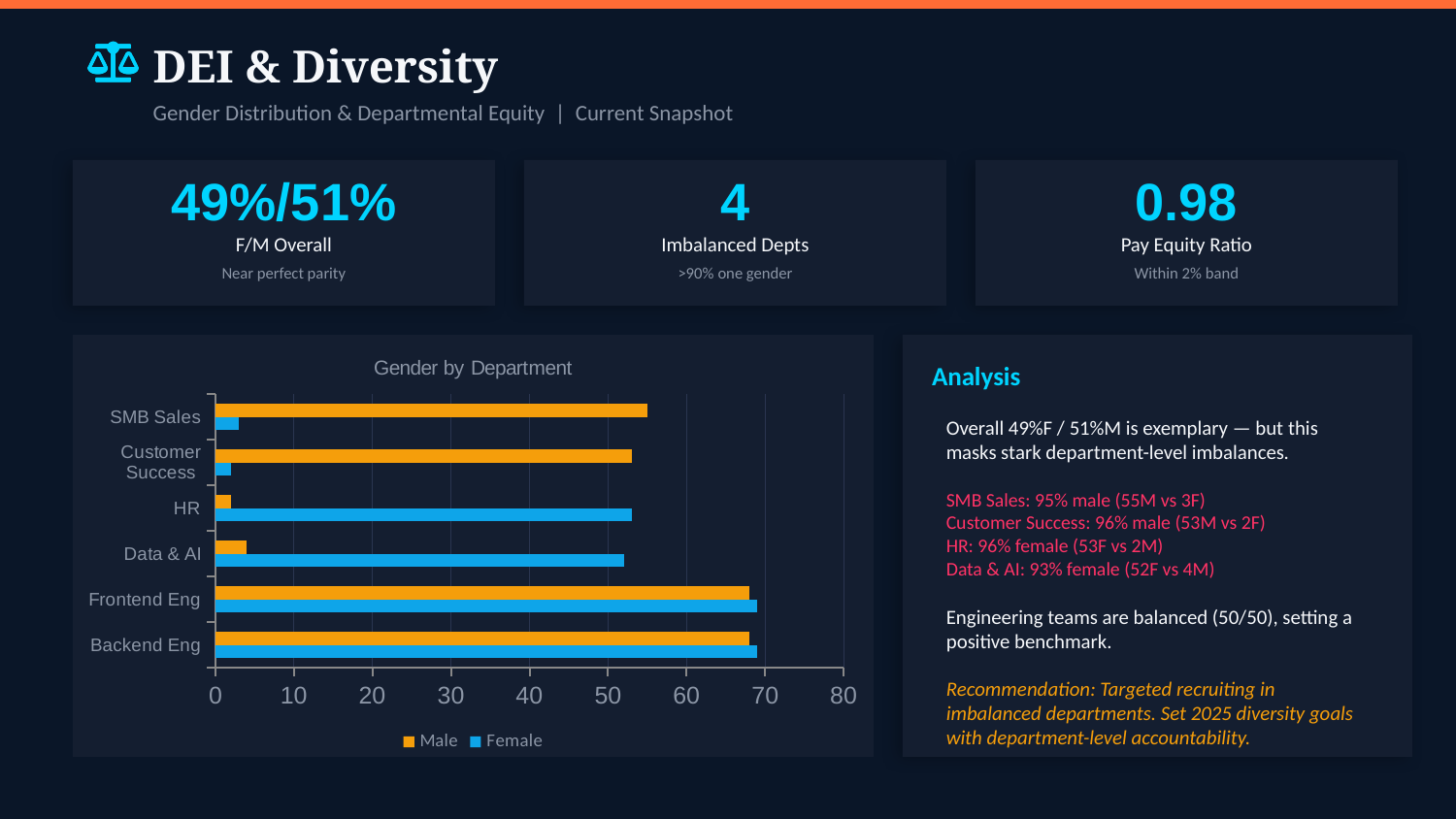
According to the slide, how many female and male employees are in Data & AI? 52F vs 4M How many series does the legend of the "Gender by Department" chart list? 2 Which two series are listed in the legend of the "Gender by Department" chart? Male and Female In the "Gender by Department" chart, which is larger for Customer Success, the Male bar or the Female bar? Male In the "Gender by Department" chart, is the Male value for SMB Sales greater or less than 50? greater How many departments are shown on the "Gender by Department" chart? 6 What kind of chart is "Gender by Department"? bar chart According to the slide, how many male and female employees are in SMB Sales? 55M vs 3F In the "Gender by Department" chart, which department has the lowest Male value? HR In the "Gender by Department" chart, which department has the lowest Female value? Customer Success In the "Gender by Department" chart, is the Female value for HR greater or less than 40? greater In the "Gender by Department" chart, is the Male value for Data & AI greater or less than 10? less